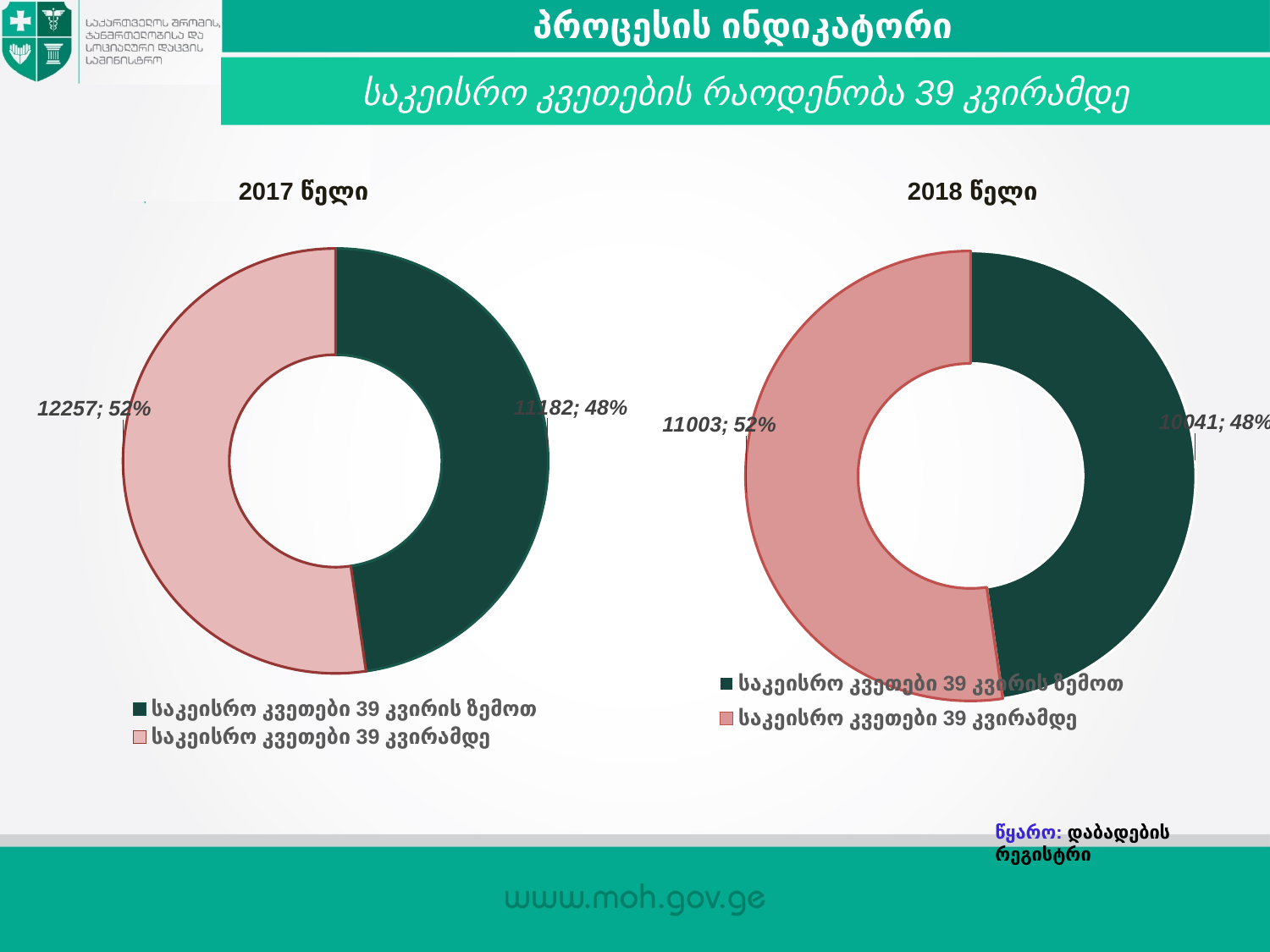
In the 2018 წელი chart, what value is shown for საკეისრო კვეთები 39 კვირის ზემოთ? 10041 How many slices does the 2018 წელი chart have? 2 In the 2017 წელი chart, which colour represents საკეისრო კვეთები 39 კვირის ზემოთ? Dark green In the 2017 წელი chart, what share of the total is საკეისრო კვეთები 39 კვირამდე? 52% In the 2017 წელი chart, what value is shown for საკეისრო კვეთები 39 კვირამდე? 12257 In the 2018 წელი chart, which category has the smaller slice? საკეისრო კვეთები 39 კვირის ზემოთ In the 2017 წელი chart, what value is shown for საკეისრო კვეთები 39 კვირის ზემოთ? 11182 What kind of chart is used for the 2017 წელი chart? Doughnut (pie) chart In the 2017 წელი chart, which category has the larger slice? საკეისრო კვეთები 39 კვირამდე In the 2017 წელი chart, what is the difference between the value for საკეისრო კვეთები 39 კვირამდე and the value for საკეისრო კვეთები 39 კვირის ზემოთ? 1075 In the 2018 წელი chart, what share of the total is საკეისრო კვეთები 39 კვირის ზემოთ? 48% In the 2018 წელი chart, what value is shown for საკეისრო კვეთები 39 კვირამდე? 11003